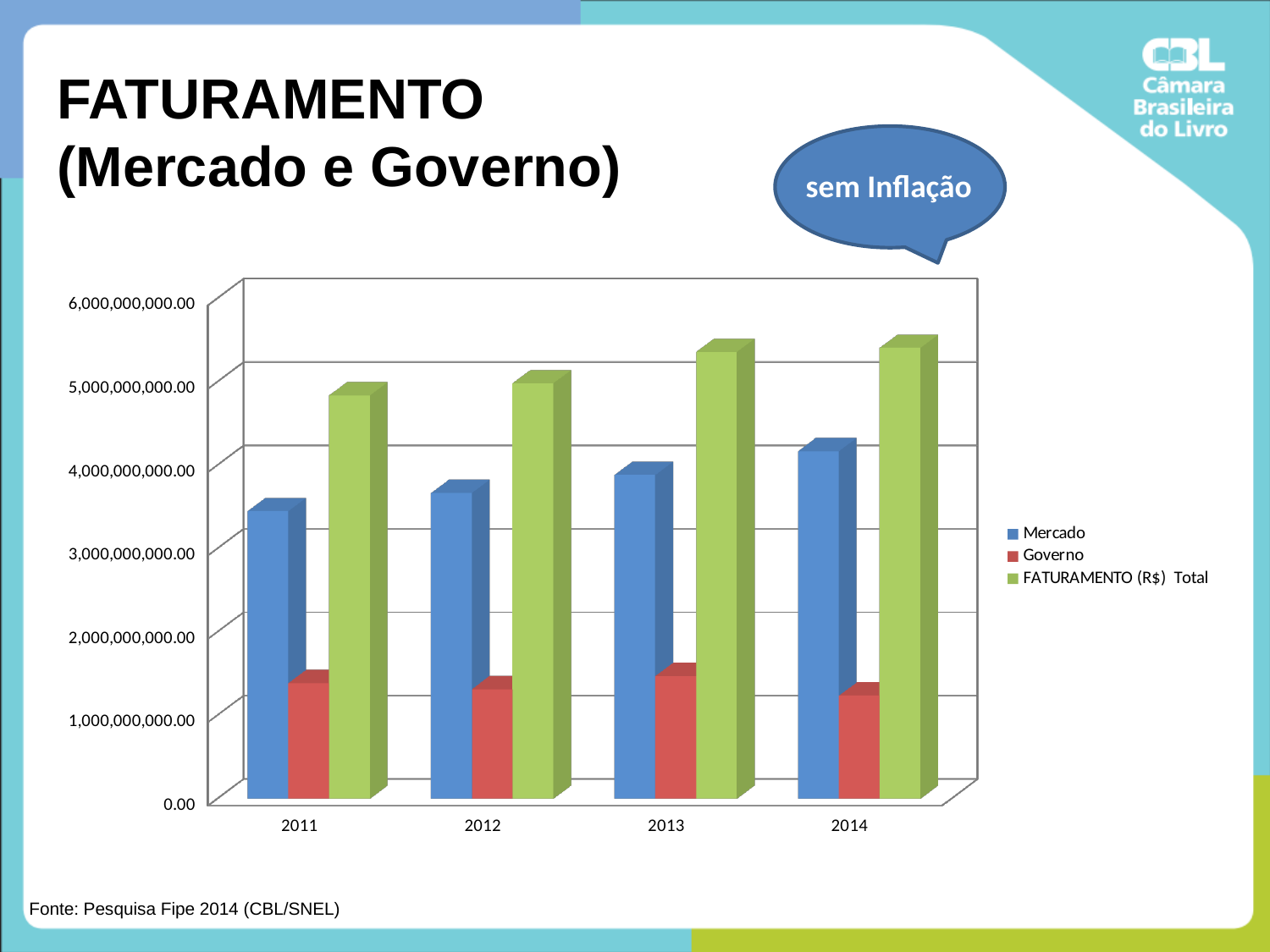
How many series does the chart legend list? 3 Is the Mercado value for 2011 greater or less than 4,000,000,000.00? less Is the Governo value for 2014 greater or less than 2,000,000,000.00? less Is the FATURAMENTO (R$) Total value for 2013 greater or less than 5,000,000,000.00? greater How many years are shown on the x axis of the chart? 4 Which series are listed in the chart legend? Mercado, Governo, FATURAMENTO (R$) Total What kind of chart is shown on the slide? bar chart In which year is the Mercado value highest? 2014 Does the Mercado series rise or fall from 2011 to 2014? rise Which is larger for FATURAMENTO (R$) Total, the 2011 value or the 2013 value? 2013 Which is larger in 2011, the Mercado value or the Governo value? Mercado